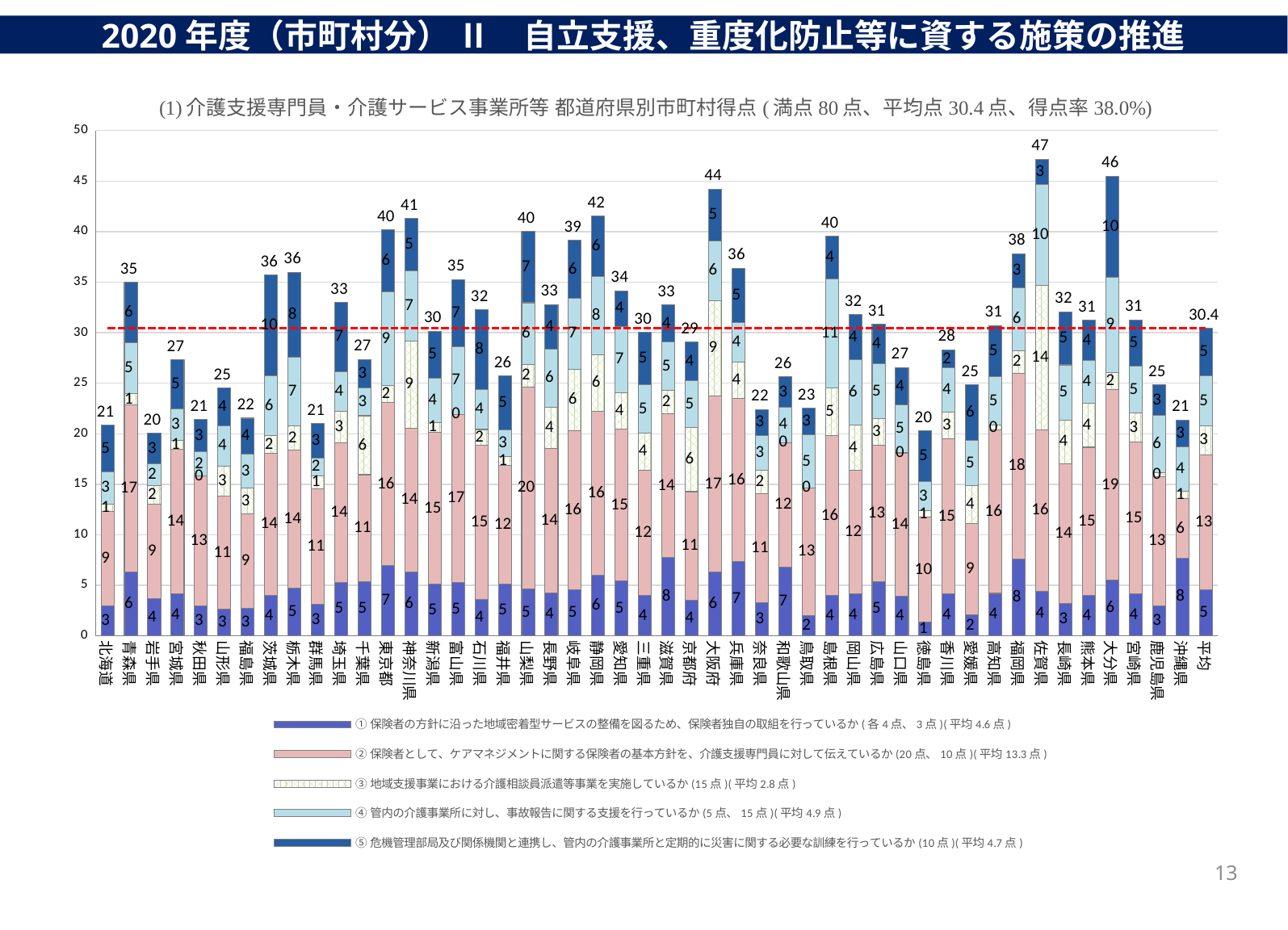
What is the total score shown for 大阪府? 44 What is the difference between the total scores of 大阪府 and 北海道? 23 What is the value shown for 平均 (the last bar)? 30.4 What is the value of the ② segment (pink) for 山梨県? 20 What kind of chart is shown on the slide? Stacked bar chart Which has a higher total score, 静岡県 or 岐阜県? 静岡県 What value does the red dashed horizontal line represent, according to the chart title? 平均点 30.4 点 What is the difference between the total scores of 佐賀県 and 大分県? 1 How many series does the legend list? 5 What is the total score shown for 佐賀県? 47 Which has a higher total score, 東京都 or 神奈川県? 神奈川県 Which prefecture has the highest total score? 佐賀県